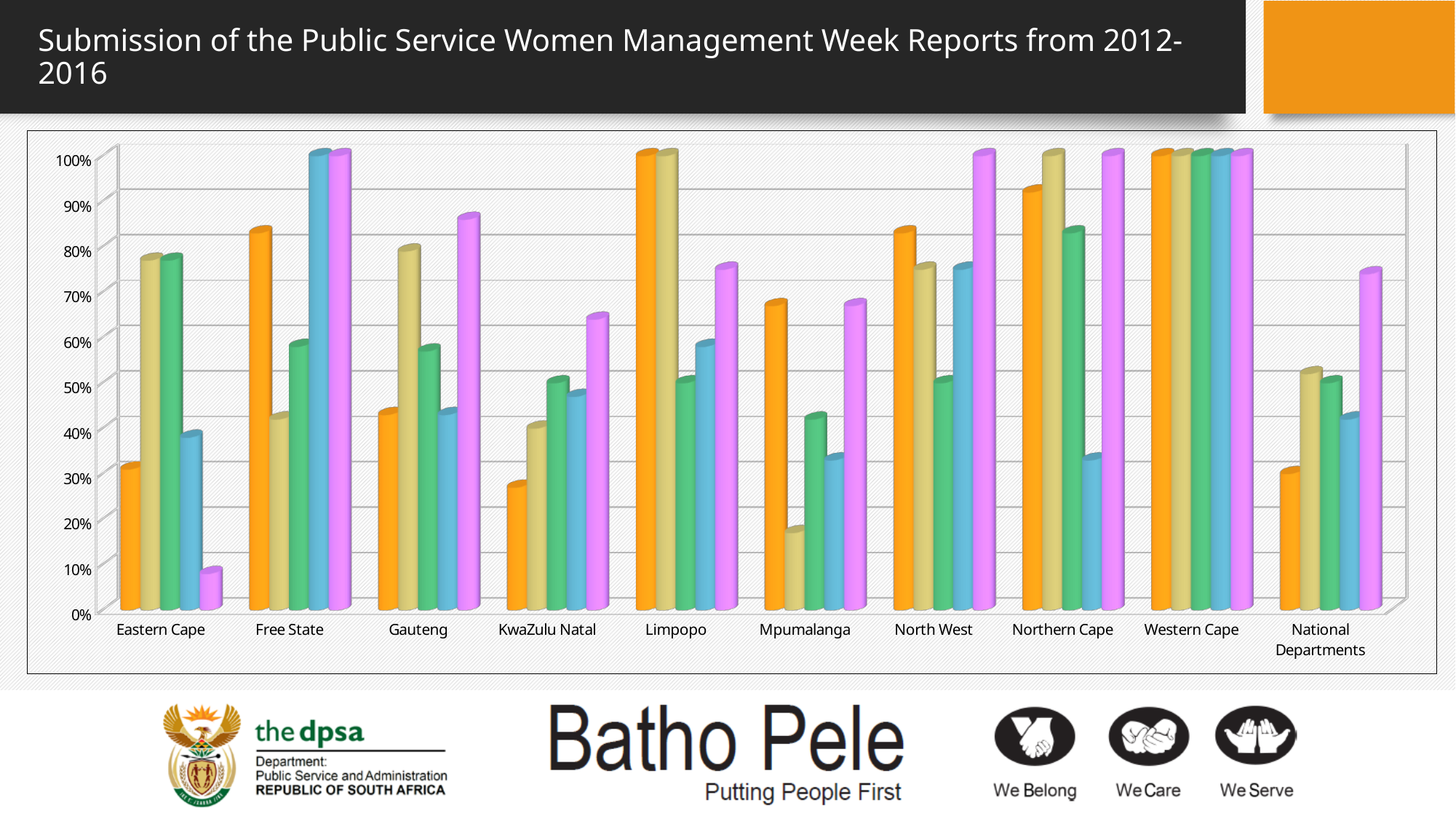
Which category has all of its bars reaching 100%? Western Cape How many categories are shown along the x axis of the chart? 10 What value do the bars for Western Cape reach? 100% Is the value of the tan bar for Mpumalanga greater or less than 20%? less Is the value of the pink bar for Eastern Cape greater or less than 10%? less What is the title of the slide containing the chart? Submission of the Public Service Women Management Week Reports from 2012-2016 Which category contains the lowest bar in the chart? Eastern Cape Which is larger, the orange bar for Free State or the orange bar for Eastern Cape? Free State What kind of chart is shown on the slide? bar chart Is the value of the pink bar for Gauteng greater or less than 80%? greater How many bars are plotted for each category in the chart? 5